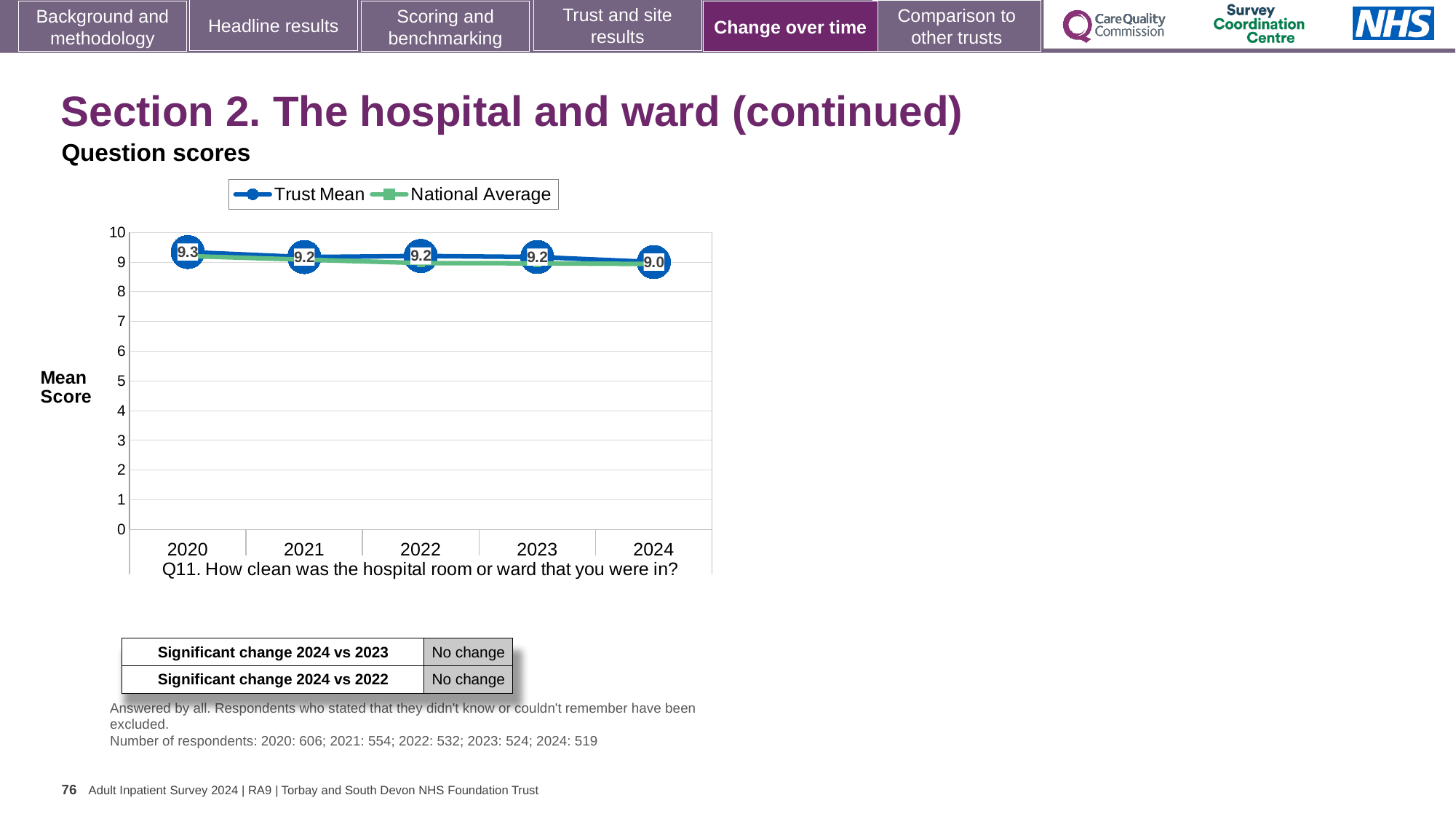
Does the Trust Mean rise or fall from 2020 to 2024? Fall What is the difference between the Trust Mean in 2020 and in 2024? 0.3 Is the National Average value for 2024 greater or less than 8? greater What kind of chart is shown? Line chart How many series does the legend list? 2 How many years are plotted on the x axis? 5 In which year is the Trust Mean highest? 2020 What is the Trust Mean value for 2020? 9.3 What is the Trust Mean value for 2022? 9.2 In which year is the Trust Mean lowest? 2024 What is the Trust Mean value for 2024? 9.0 Which is larger, the Trust Mean for 2020 or for 2024? 2020